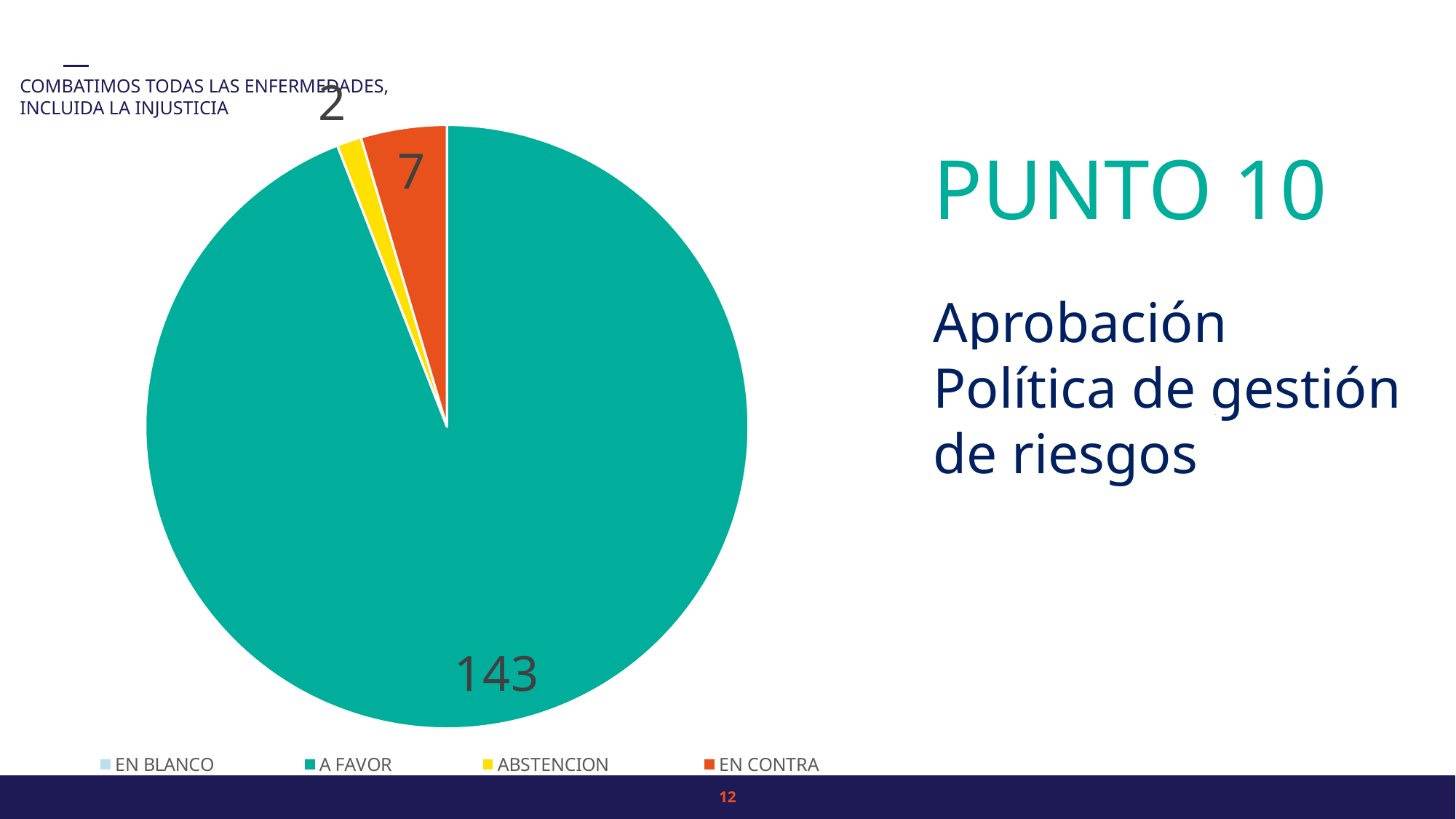
What is the difference between the values for A FAVOR and EN CONTRA? 136 What is the value for EN CONTRA in the pie chart? 7 Which of the labelled categories has the smallest value in the pie chart? ABSTENCION What kind of chart is shown on the slide? pie chart What is the value for ABSTENCION in the pie chart? 2 Which legend entry is shown in orange? EN CONTRA Which is larger, the value for EN CONTRA or the value for ABSTENCION? EN CONTRA What is the value for A FAVOR in the pie chart? 143 What is the difference between the values for EN CONTRA and ABSTENCION? 5 What colour is the A FAVOR slice in the pie chart? teal How many categories does the legend of the pie chart list? 4 Which category has the largest slice in the pie chart? A FAVOR